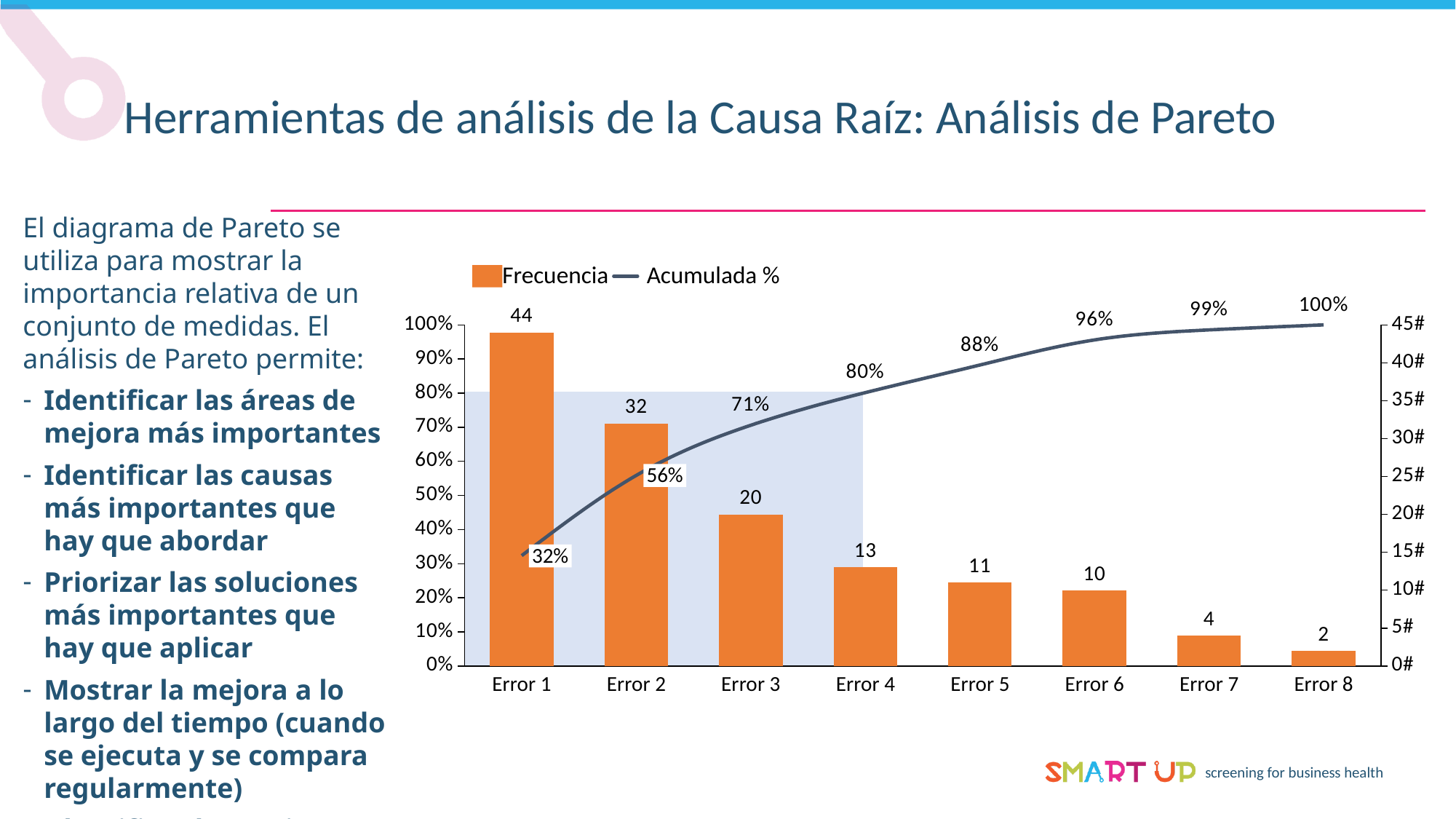
What is the Acumulada % value at Error 4? 80% Which category has the lowest Frecuencia? Error 8 What is the Frecuencia value for Error 3? 20 Which has a higher Frecuencia, Error 5 or Error 6? Error 5 What is the difference in Frecuencia between Error 1 and Error 2? 12 What are the two series named in the legend? Frecuencia and Acumulada % How many series does the legend list? 2 How many categories are shown on the x axis? 8 Does the Acumulada % line rise or fall from Error 1 to Error 8? rise What is the Frecuencia value for Error 7? 4 What is the Acumulada % value at Error 2? 56% Which category has the highest Frecuencia? Error 1